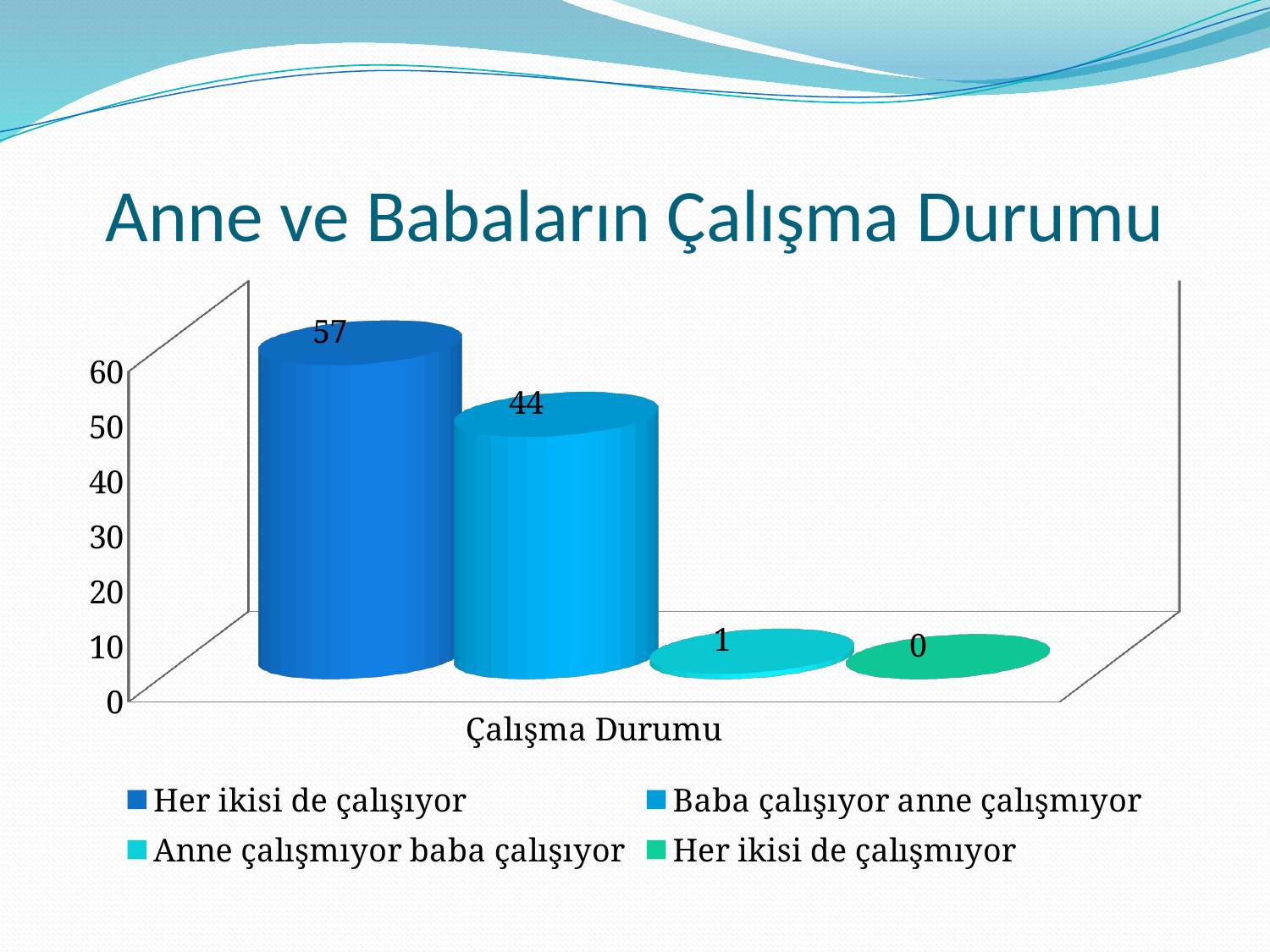
Which series has the lowest value? Her ikisi de çalışmıyor What is the difference between the values for "Her ikisi de çalışıyor" and "Baba çalışıyor anne çalışmıyor"? 13 What is the value for "Her ikisi de çalışmıyor"? 0 What is the title of the chart? Anne ve Babaların Çalışma Durumu What kind of chart is shown on the slide? Bar chart Which is larger: the value for "Baba çalışıyor anne çalışmıyor" or the value for "Anne çalışmıyor baba çalışıyor"? Baba çalışıyor anne çalışmıyor What is the value for "Baba çalışıyor anne çalışmıyor"? 44 What is the label on the x axis of the chart? Çalışma Durumu Which series has the highest value? Her ikisi de çalışıyor What is the value for "Anne çalışmıyor baba çalışıyor"? 1 What is the value for "Her ikisi de çalışıyor"? 57 How many series does the legend list? 4